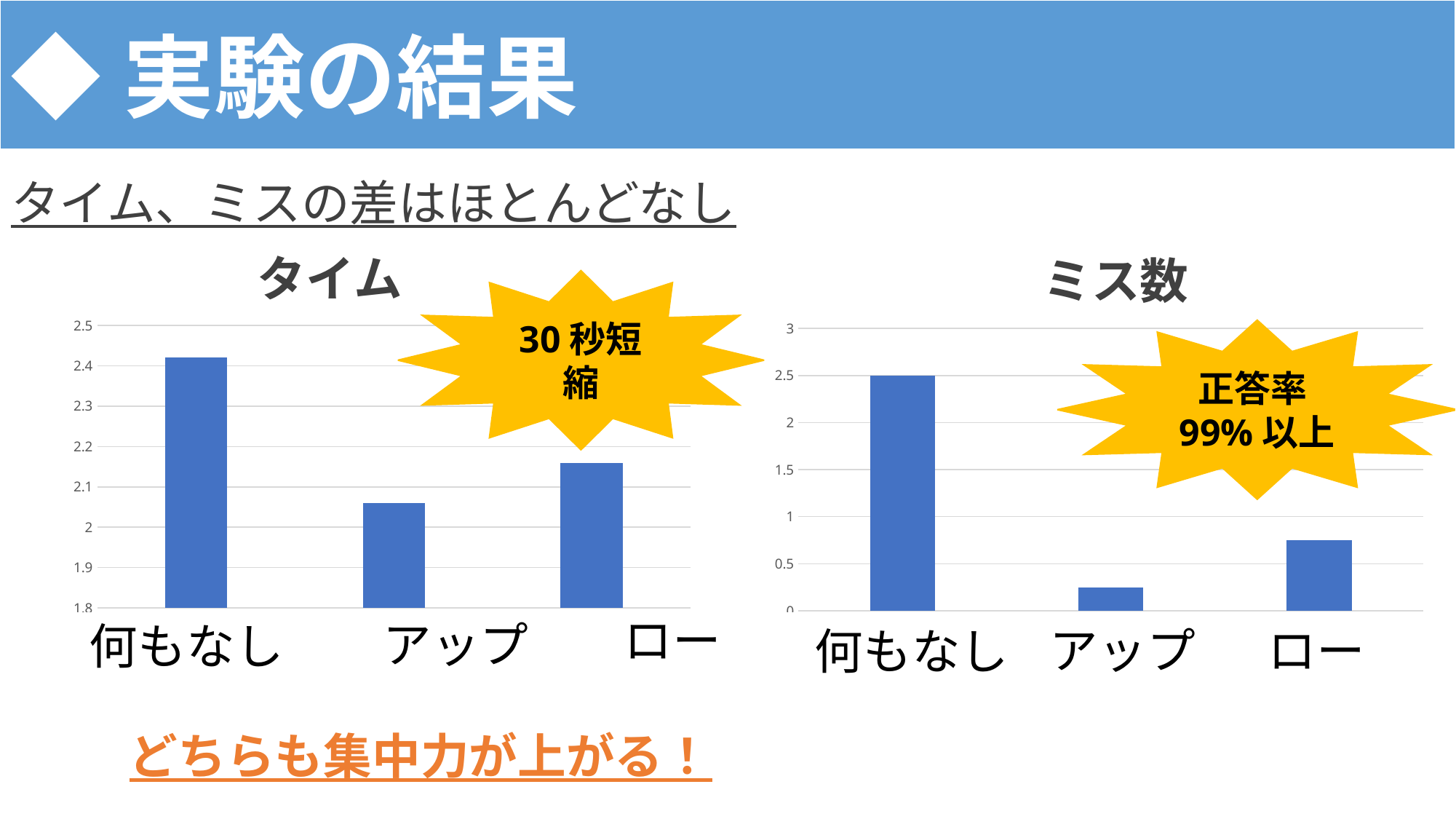
In the タイム chart, is the value for 何もなし greater or less than 2.4? greater In the ミス数 chart, which category has the lowest value? アップ What kind of chart is the タイム chart? bar chart In the タイム chart, which is larger, the value for ロー or the value for アップ? ロー In the ミス数 chart, is the value for ロー greater or less than 1? less How many categories does the ミス数 chart show? 3 In the ミス数 chart, which category has the highest value? 何もなし What is the title of the chart on the right side of the slide? ミス数 In the ミス数 chart, what is the value for 何もなし? 2.5 In the タイム chart, is the value for アップ greater or less than 2.1? less In the タイム chart, which category has the highest value? 何もなし In the タイム chart, which category has the lowest value? アップ